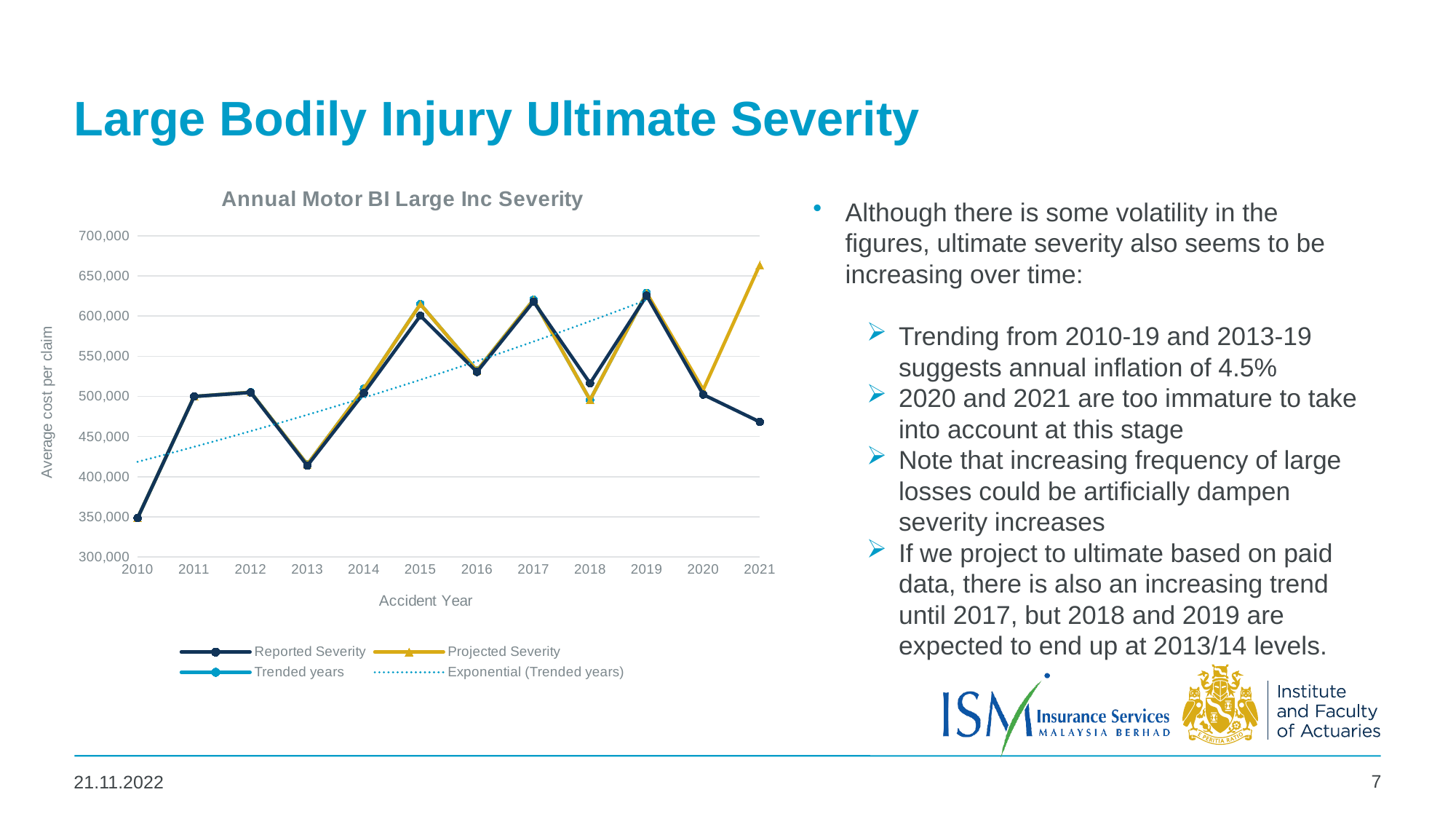
What is the title of the chart? Annual Motor BI Large Inc Severity Is the Reported Severity value for 2013 greater or less than 450,000? less What is the label of the y axis of the chart? Average cost per claim Does Reported Severity rise or fall from 2019 to 2021? Fall How many series does the chart legend list? 4 In which accident year is Projected Severity highest? 2021 Is the Projected Severity value for 2021 greater or less than 650,000? greater How many accident years are shown on the x axis of the chart? 12 Which is larger for 2021: Reported Severity or Projected Severity? Projected Severity In which accident year is Reported Severity lowest? 2010 What kind of chart is shown on the slide? Line chart Is the Reported Severity value for 2021 greater or less than 500,000? less